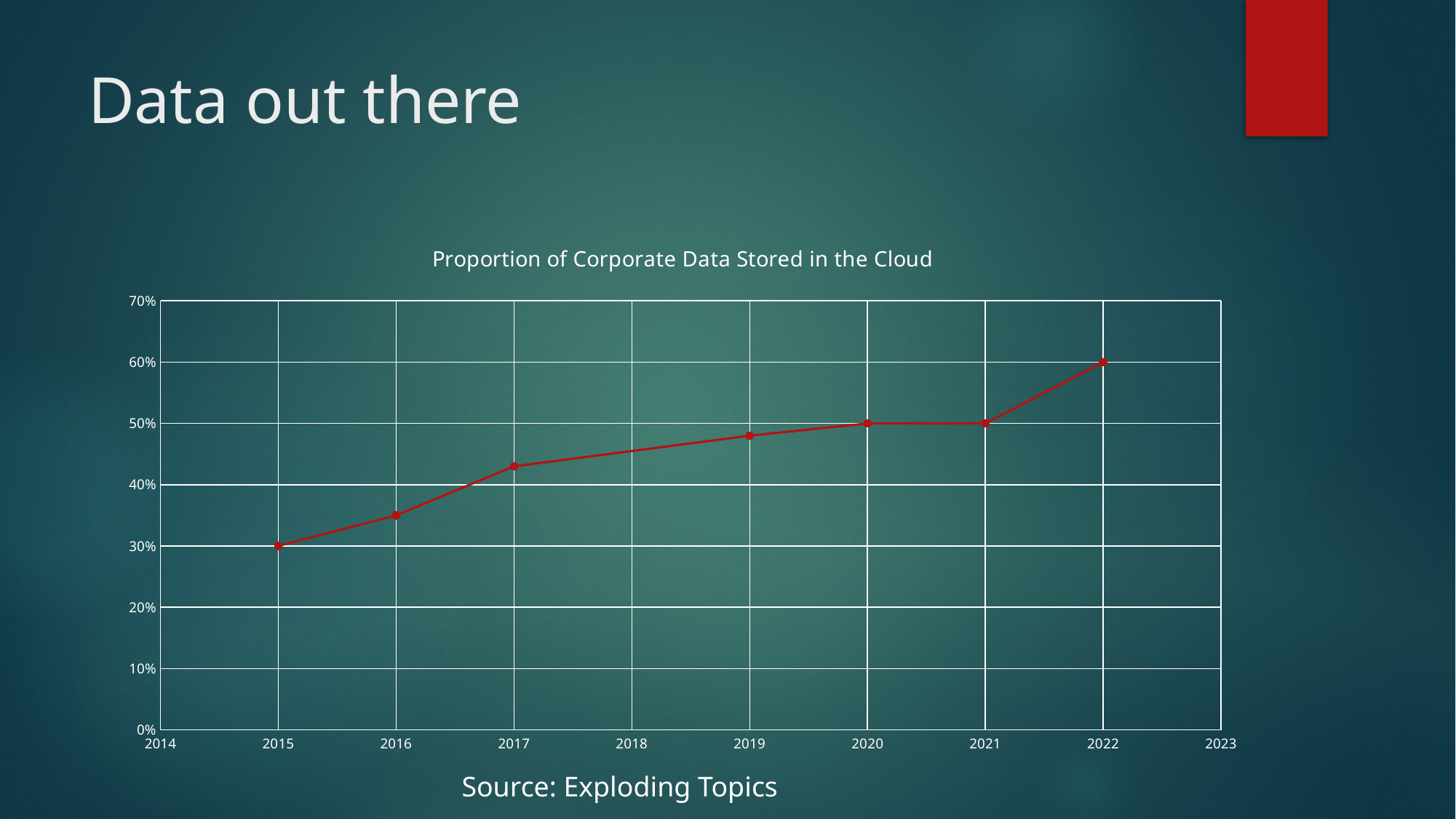
Which year has the lowest value? 2015 What is the value for 2020? 50% What kind of chart is shown on the slide? line chart Which year has the highest value? 2022 What is the difference between the values for 2022 and 2015? 30 percentage points Is the value for 2017 greater or less than 40%? greater What is the title of the chart? Proportion of Corporate Data Stored in the Cloud What is the value for 2022? 60% Is the value for 2016 greater or less than 40%? less Do the values generally rise or fall from 2015 to 2022? rise What is the value for 2015? 30% Which is larger, the value for 2017 or the value for 2019? 2019